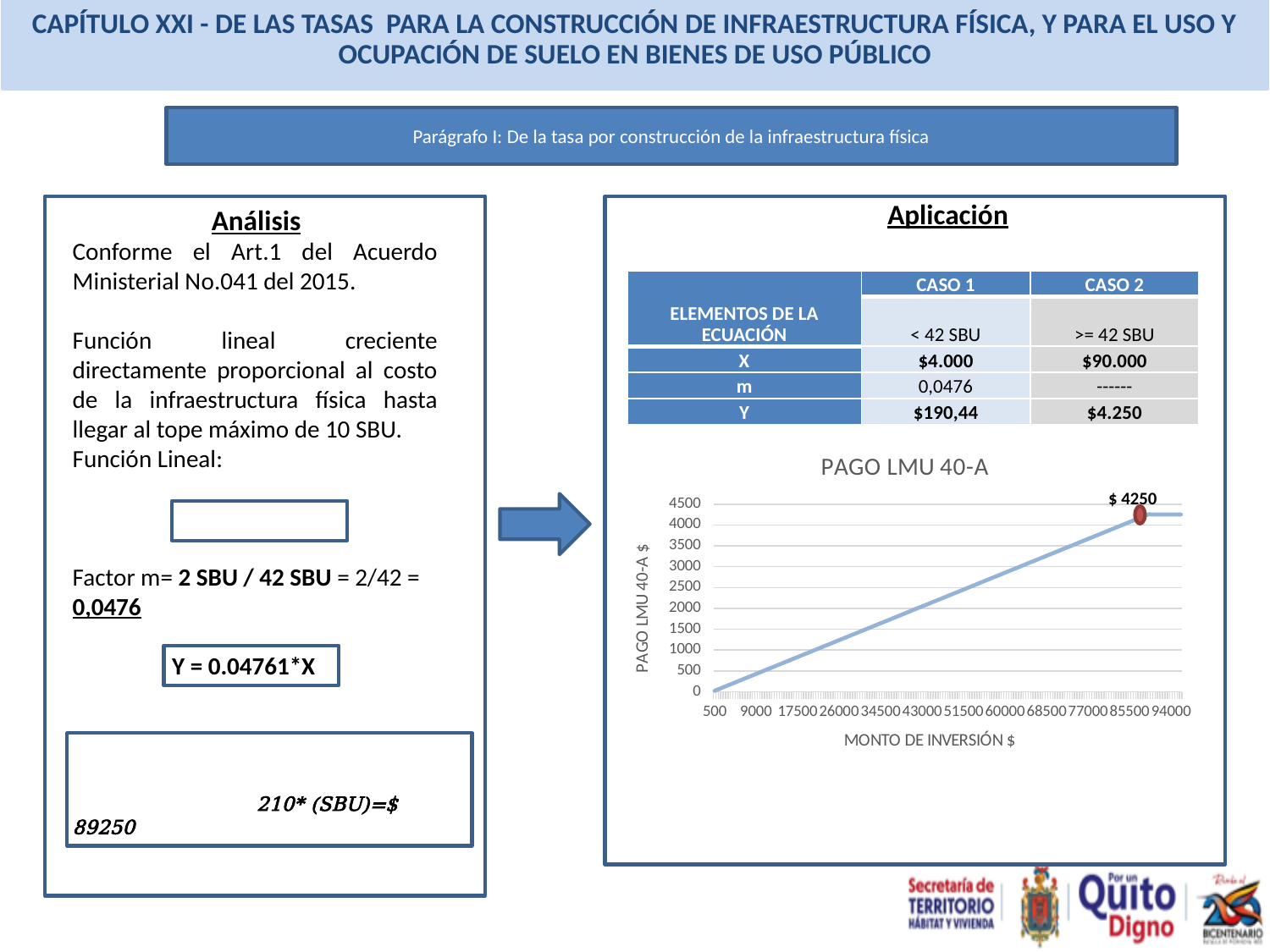
Is the value of the line at an investment amount of 51500 greater or less than 2000? greater What value is printed as the data label at the top of the line in the chart? $ 4250 Is the value of the line at an investment amount of 77000 greater or less than 3000? greater Which is larger in the chart: the value of the line at 17500 or at 68500? 68500 What is the title of the chart? PAGO LMU 40-A Does the line in the chart rise or fall as the investment amount increases from 500 to 85500? rise What is the highest tick value shown on the y axis of the chart? 4500 How many tick labels are shown on the x axis of the chart? 12 What is the label of the x axis of the chart? MONTO DE INVERSIÓN $ Is the value of the line at an investment amount of 26000 greater or less than 1500? less What kind of chart is shown on the slide? line chart